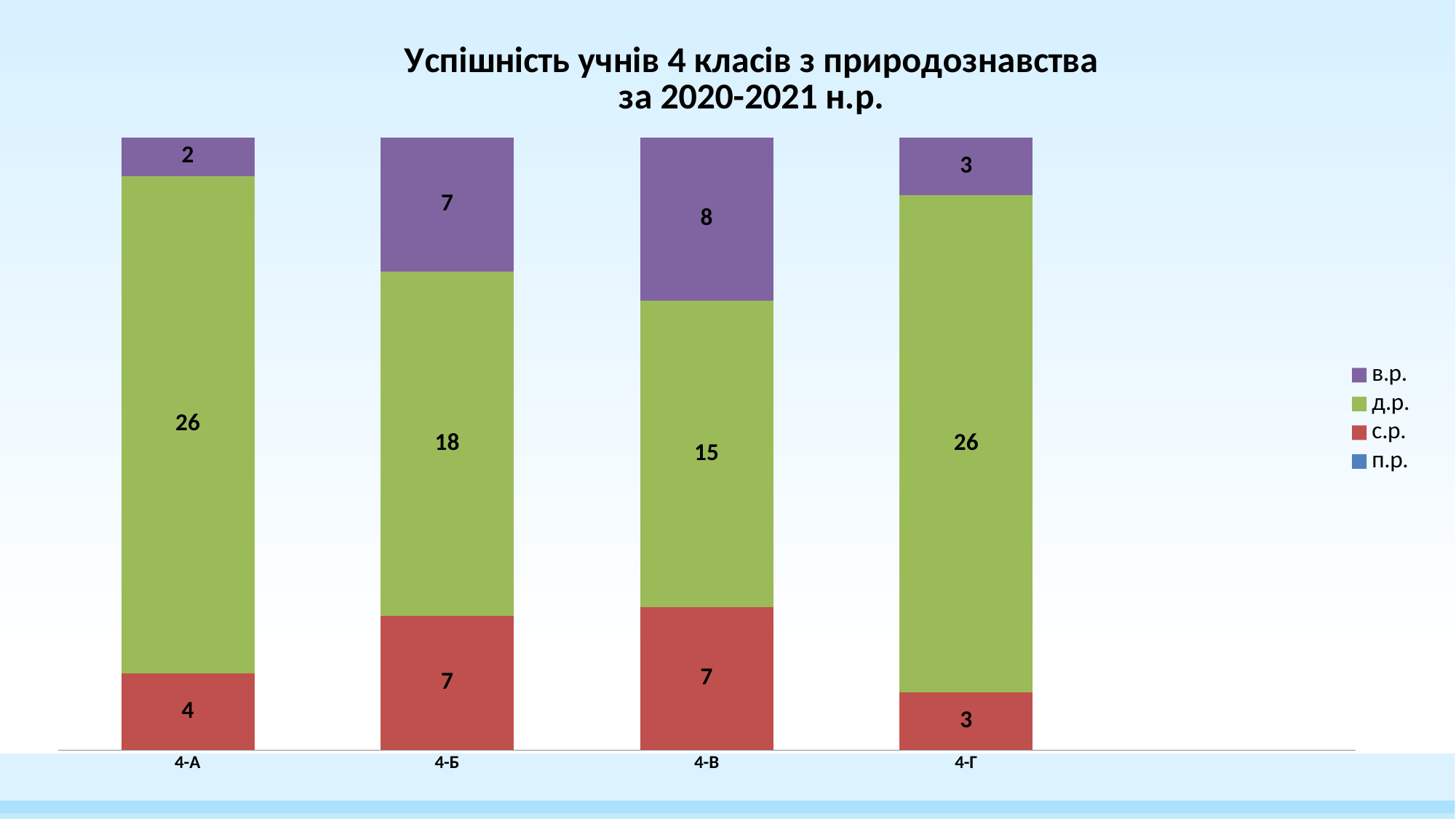
Which legend entry is shown in green? д.р. What is the value of the с.р. segment for class 4-Г? 3 What is the difference between the д.р. values for 4-А and 4-В? 11 What is the sum of the labelled segments in the bar for 4-Б? 32 What kind of chart is shown on the slide? Stacked bar chart Which class has the larger с.р. value, 4-А or 4-Б? 4-Б How many classes are shown on the x axis? 4 Which class has the lowest в.р. value? 4-А What is the value of the в.р. segment for class 4-В? 8 Which class has the highest в.р. value? 4-В How many series does the legend list? 4 What is the value of the д.р. segment for class 4-Б? 18